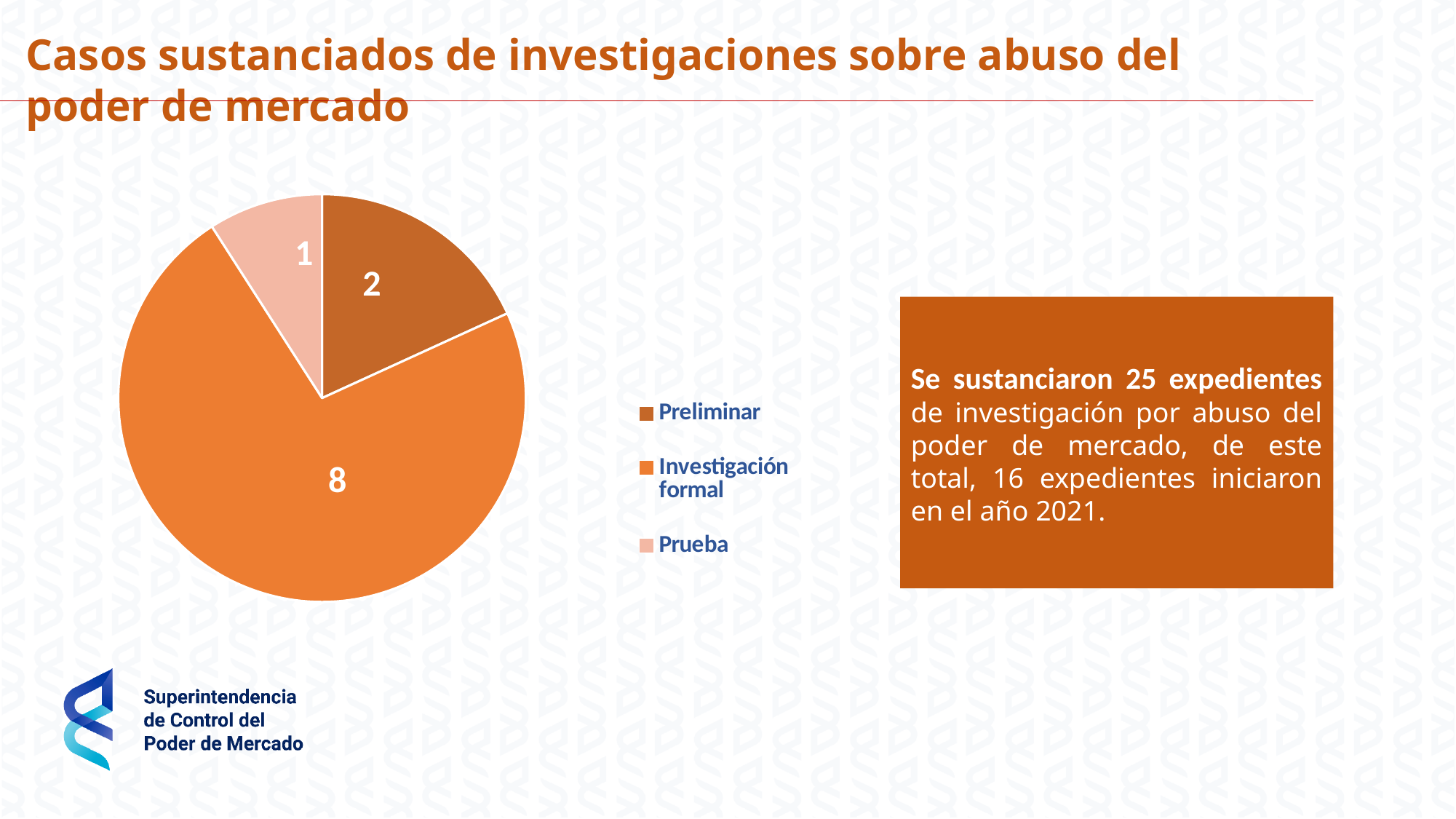
What is the difference between the Investigación formal and Preliminar values in the pie chart? 6 Which is larger in the pie chart, Preliminar or Prueba? Preliminar What is the total of all the slices in the pie chart? 11 How many cases are in the Investigación formal slice of the pie chart? 8 What is the value of the Prueba slice in the pie chart? 1 Which category has the largest slice in the pie chart? Investigación formal Which category has the smallest slice in the pie chart? Prueba What share of the pie chart total does the Investigación formal slice represent? 8 out of 11 What is the value of the Preliminar slice in the pie chart? 2 How many slices does the pie chart have? 3 Which legend entry is shown with the lightest colour in the pie chart? Prueba What type of chart is shown on the slide? pie chart